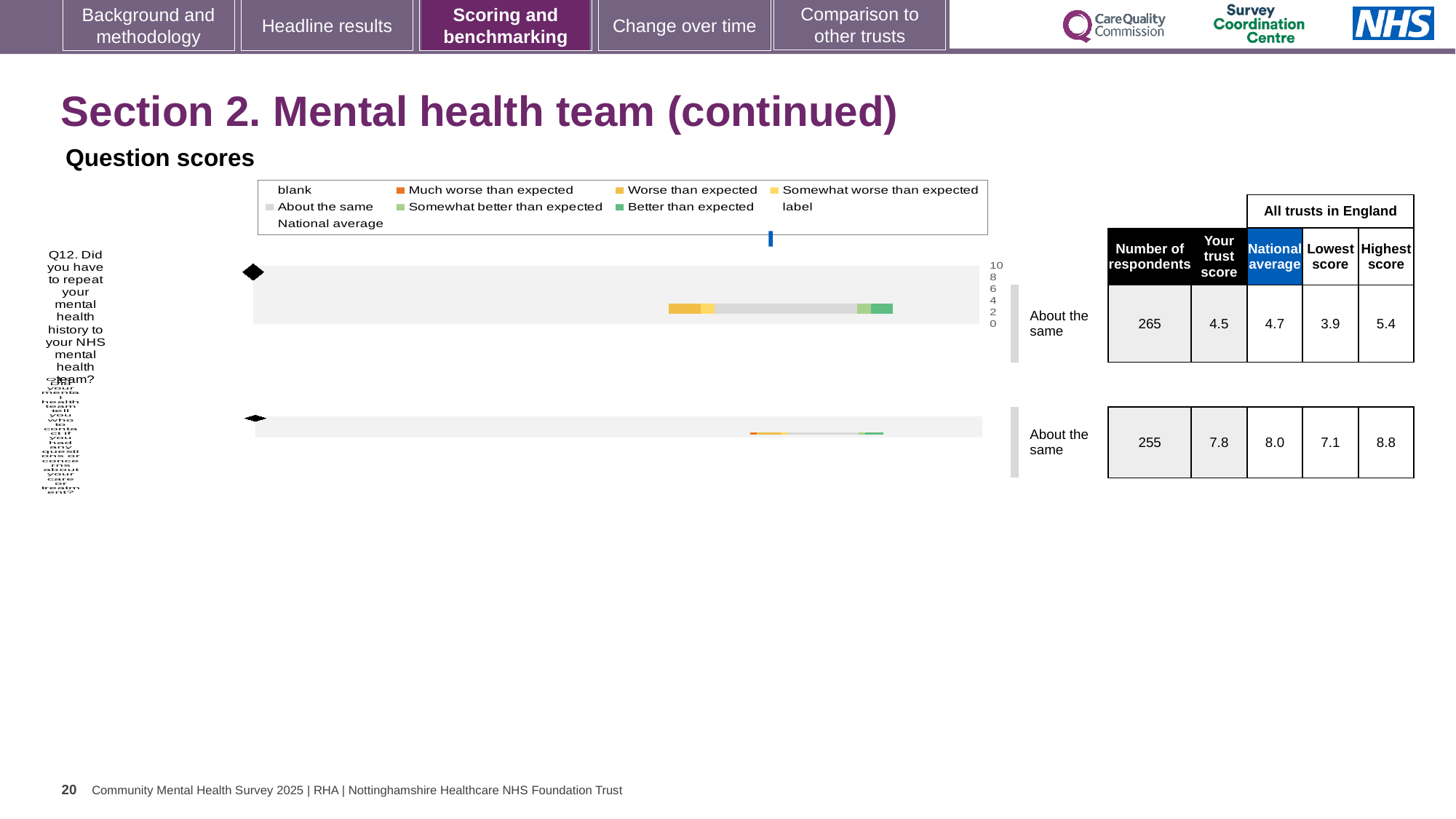
What is the national average for Q12 (repeating mental health history)? 4.7 How many questions are plotted in the question scores chart? 2 Which is larger for Q12: the trust score or the national average? national average How many respondents are shown for Q12 (repeating mental health history)? 265 What benchmark category is shown for Q12 (repeating mental health history)? About the same What is the highest score among all trusts in England for the second question row in the chart? 8.8 In the question scores chart legend, what colour represents "Much worse than expected"? orange What kind of chart is used to show the question scores on this slide? bar chart What is the trust score for Q12 (repeating mental health history)? 4.5 What is the trust score for the second question row in the chart? 7.8 In the question scores chart legend, what colour represents "Better than expected"? green What is the difference between the highest score and the lowest score for Q12? 1.5